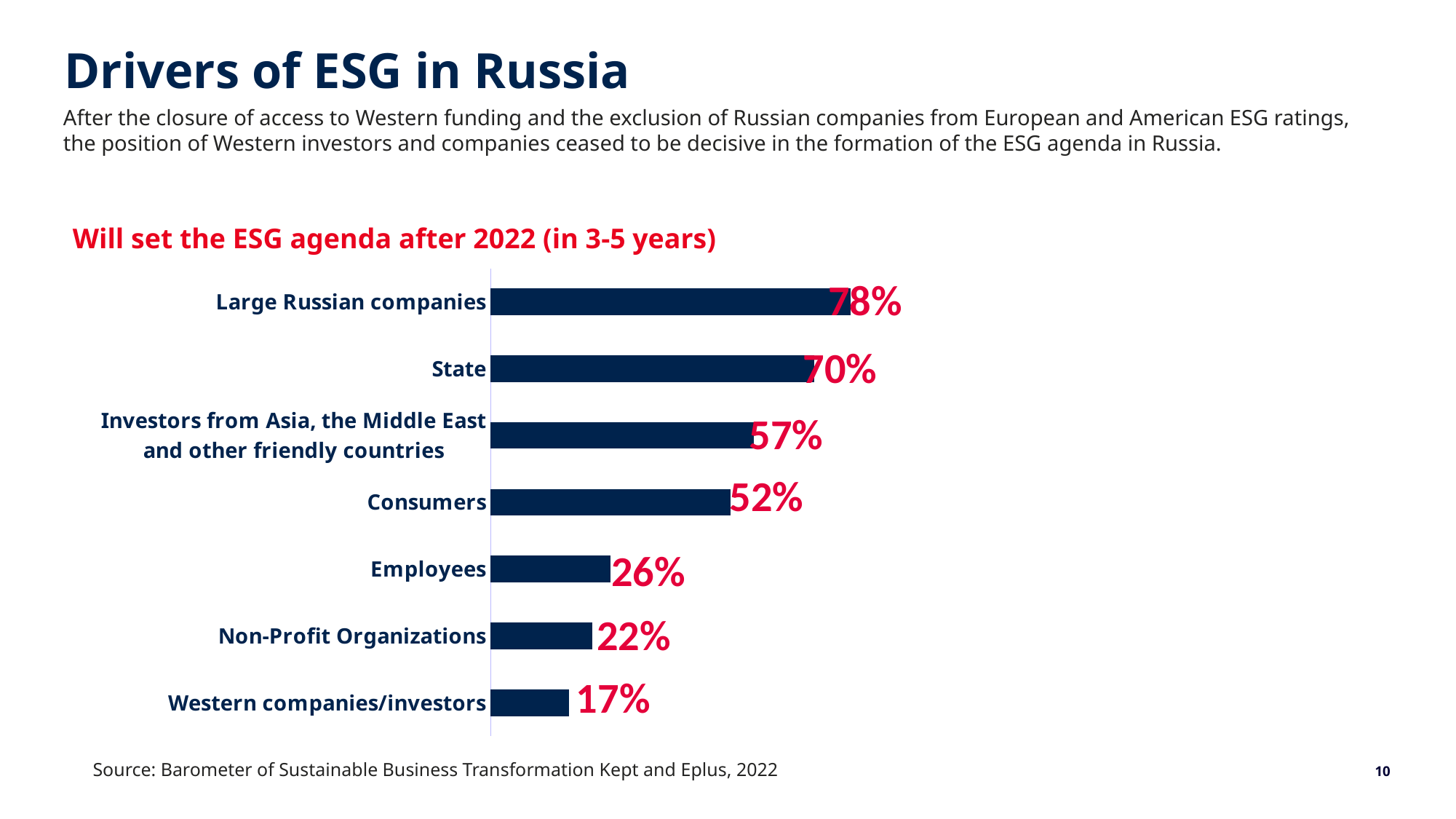
Which category has the highest value? Large Russian companies What is the difference between the values for Employees and Western companies/investors? 9% What value is shown for Investors from Asia, the Middle East and other friendly countries? 57% How many categories are shown in the chart? 7 What is the difference between the values for State and Consumers? 18% What kind of chart is shown on the slide? Bar chart What colour are the bars in the chart? Dark navy blue Which is larger, the value for Consumers or the value for Employees? Consumers What percentage is shown for Non-Profit Organizations? 22% Which category has the lowest value? Western companies/investors What is the title of the chart? Will set the ESG agenda after 2022 (in 3-5 years) What percentage is shown for Large Russian companies? 78%